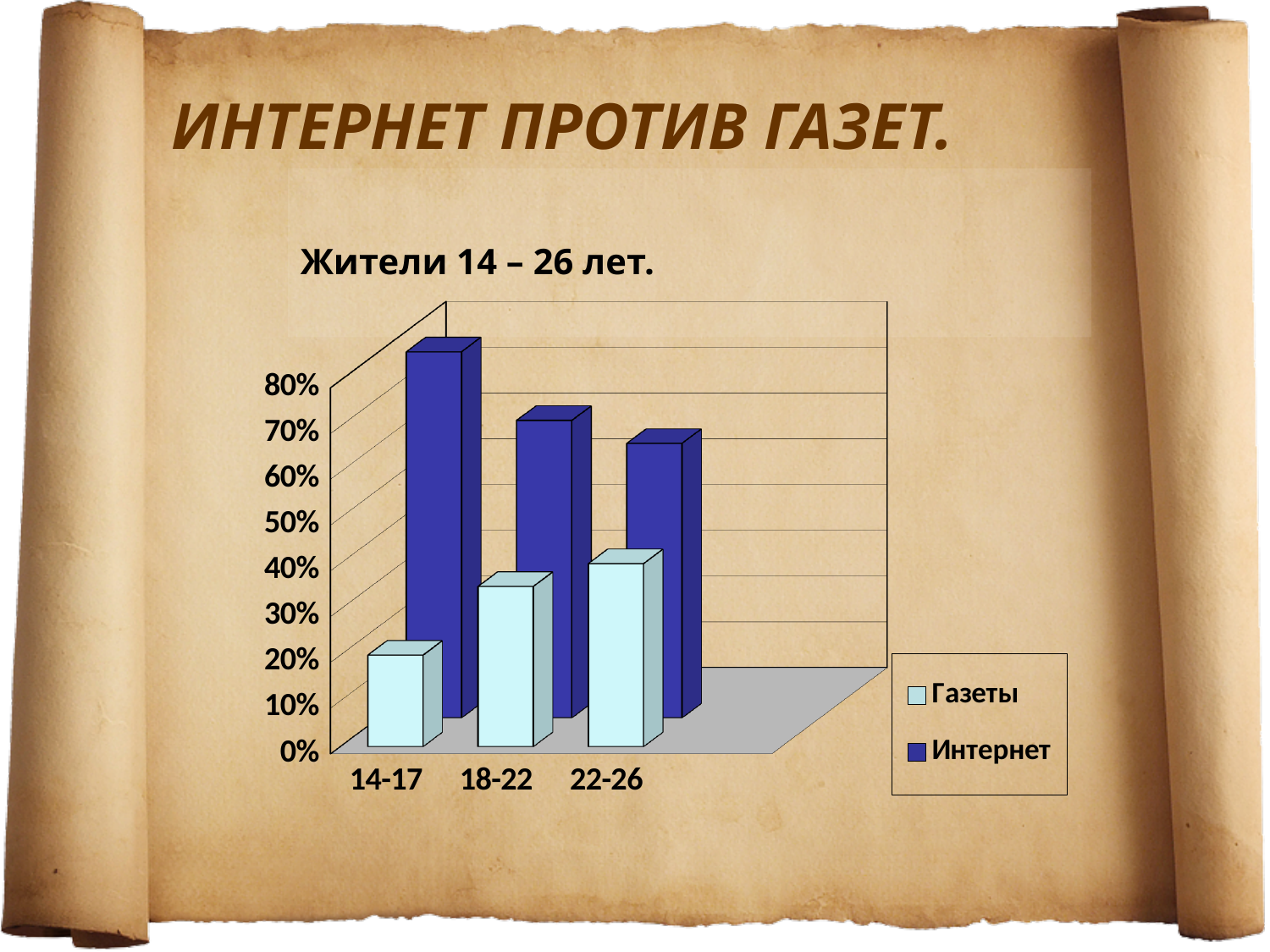
What kind of chart is shown on the slide? bar chart What is the title of the chart? Жители 14 – 26 лет. How many series does the legend list? 2 Which series is shown in dark blue? Интернет Is the Интернет value for 14-17 greater or less than 70%? greater How many age categories are shown on the x axis? 3 Do the Интернет values rise or fall from 14-17 to 22-26? fall For which age group is the Газеты value lowest? 14-17 For the 22-26 age group, which is larger: Газеты or Интернет? Интернет Is the Газеты value for 14-17 greater or less than 30%? less For which age group is the Интернет value highest? 14-17 Do the Газеты values rise or fall from 14-17 to 22-26? rise